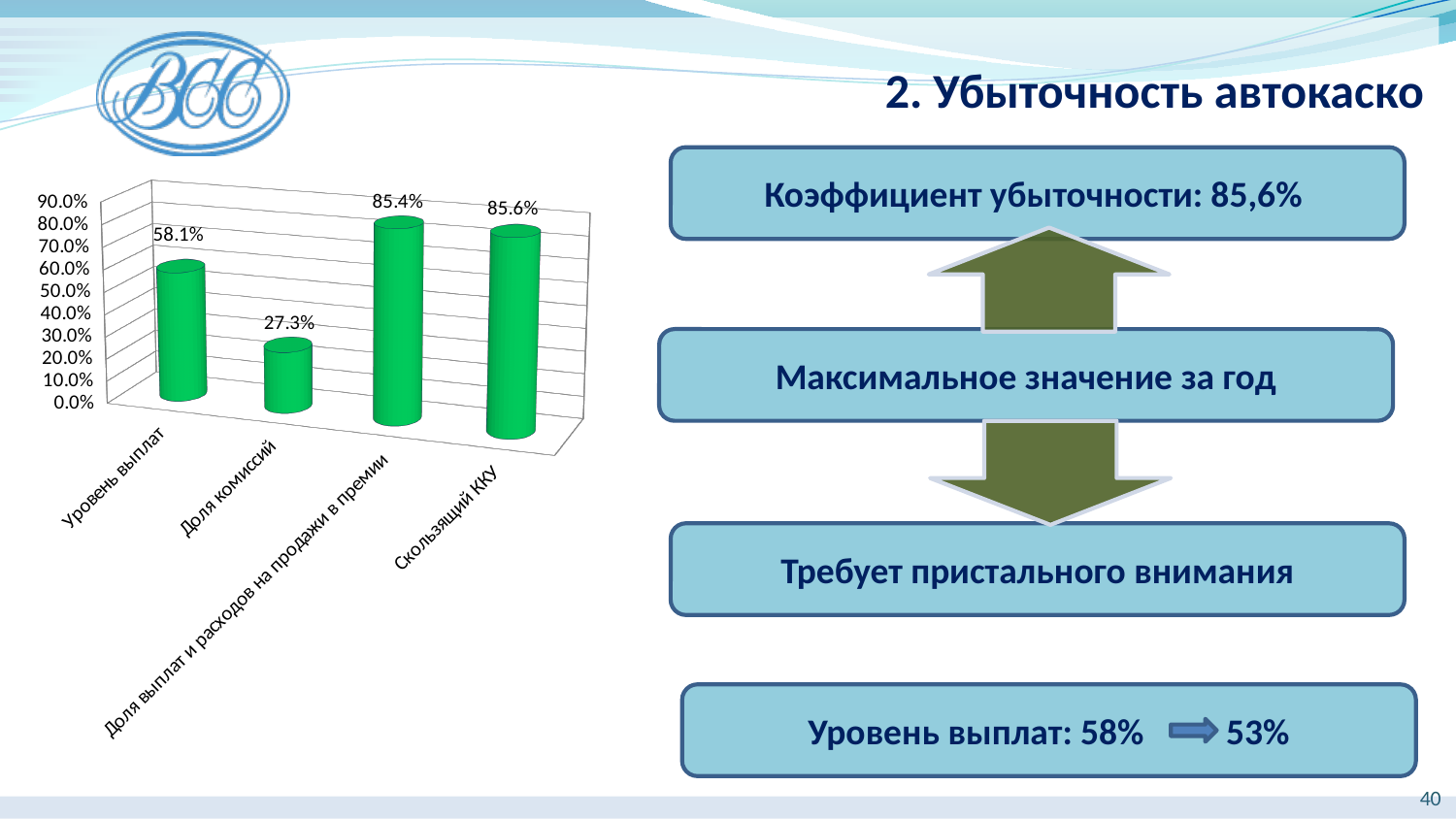
Is the value for Доля комиссий greater or less than 30%? less What is the highest tick label on the vertical axis of the chart? 90.0% What is the value for Доля комиссий in the bar chart? 27.3% Which is larger, the value for Уровень выплат or the value for Доля комиссий? Уровень выплат What is the difference between the values for Уровень выплат and Доля комиссий? 30.8 percentage points What is the value for Уровень выплат in the bar chart? 58.1% How many categories are shown in the bar chart? 4 What is the value for Скользящий ККУ in the bar chart? 85.6% What is the difference between the values for Скользящий ККУ and Уровень выплат? 27.5 percentage points What kind of chart is shown on the slide? bar chart Which category has the lowest value in the bar chart? Доля комиссий What is the value for Доля выплат и расходов на продажи в премии in the bar chart? 85.4%